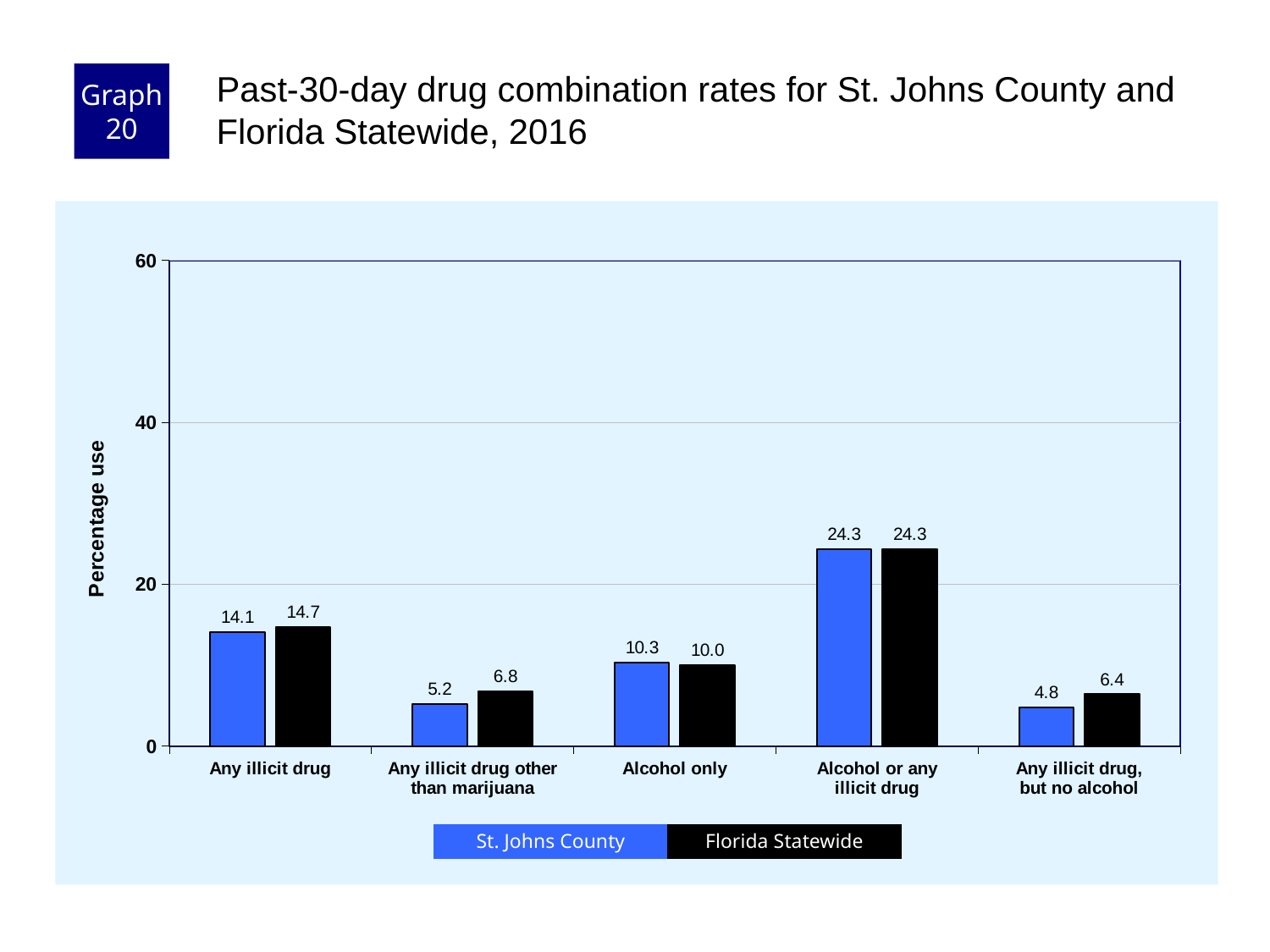
What is the Florida Statewide value for Any illicit drug other than marijuana? 6.8 What is the difference between the Florida Statewide and St. Johns County values for Any illicit drug, but no alcohol? 1.6 How many categories are shown on the x axis? 5 What is the label of the y axis? Percentage use Which category has the lowest Florida Statewide value? Any illicit drug, but no alcohol How many series does the legend list? 2 What kind of chart is shown on the slide? bar chart Which category has the highest St. Johns County value? Alcohol or any illicit drug What is the St. Johns County value for Alcohol only? 10.3 Is the Florida Statewide value for Alcohol or any illicit drug greater or less than 20? greater What is the St. Johns County value for Any illicit drug? 14.1 Which is larger for Any illicit drug other than marijuana: St. Johns County or Florida Statewide? Florida Statewide